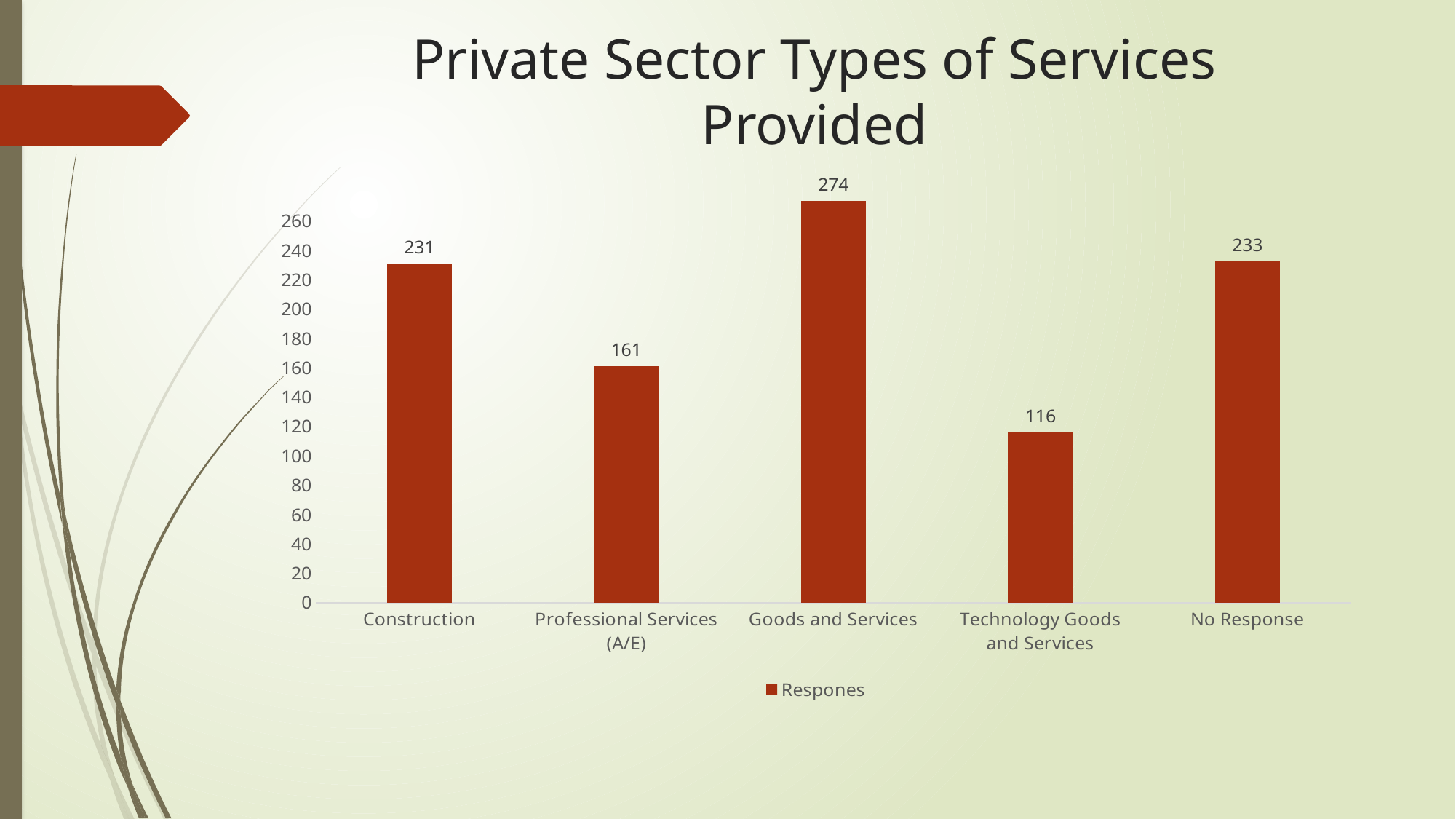
Which category has the highest value? Goods and Services What kind of chart is shown on the slide? bar chart What is the difference between the values for Goods and Services and Technology Goods and Services? 158 Is the value for Professional Services (A/E) greater or less than 200? less How many categories are shown on the x axis? 5 What is the value for Professional Services (A/E)? 161 What is the value for Technology Goods and Services? 116 What series name does the legend show? Respones Which is larger, the value for Construction or the value for Professional Services (A/E)? Construction What is the value for Construction? 231 What is the value for No Response? 233 Which category has the lowest value? Technology Goods and Services